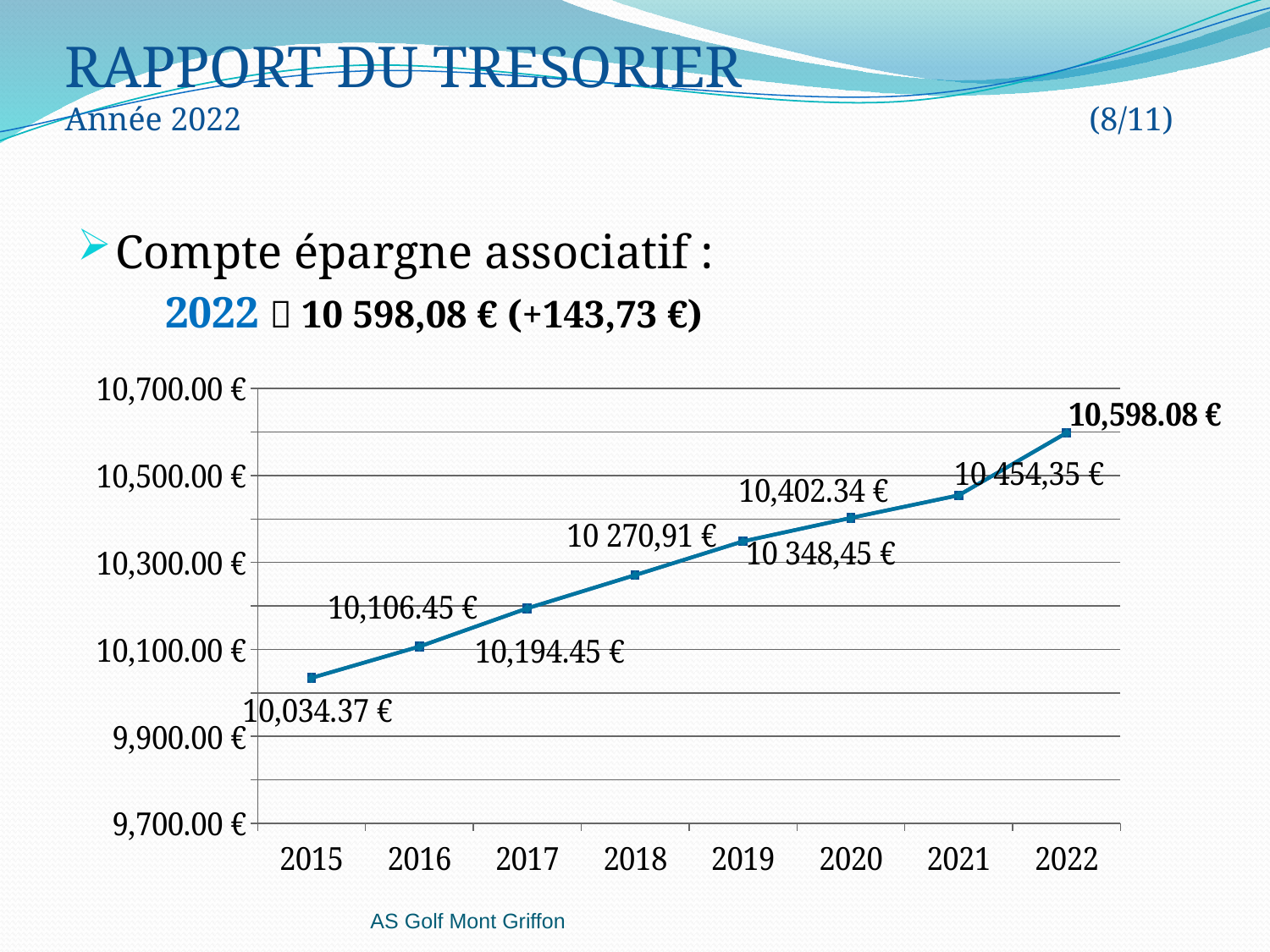
Do the values rise or fall from 2015 to 2022? rise Which year has the highest value on the chart? 2022 Is the value for 2016 greater or less than 10,300.00 €? less Which year has the lowest value on the chart? 2015 What is the value plotted for 2020? 10,402.34 € What is the difference between the 2022 value and the 2021 value? 143,73 € What is the value plotted for 2018? 10 270,91 € What type of chart is shown on the slide? line chart Which is larger, the value for 2019 or the value for 2017? 2019 What is the value plotted for 2022? 10,598.08 € How many years are plotted on the x axis? 8 What is the value plotted for 2015? 10,034.37 €